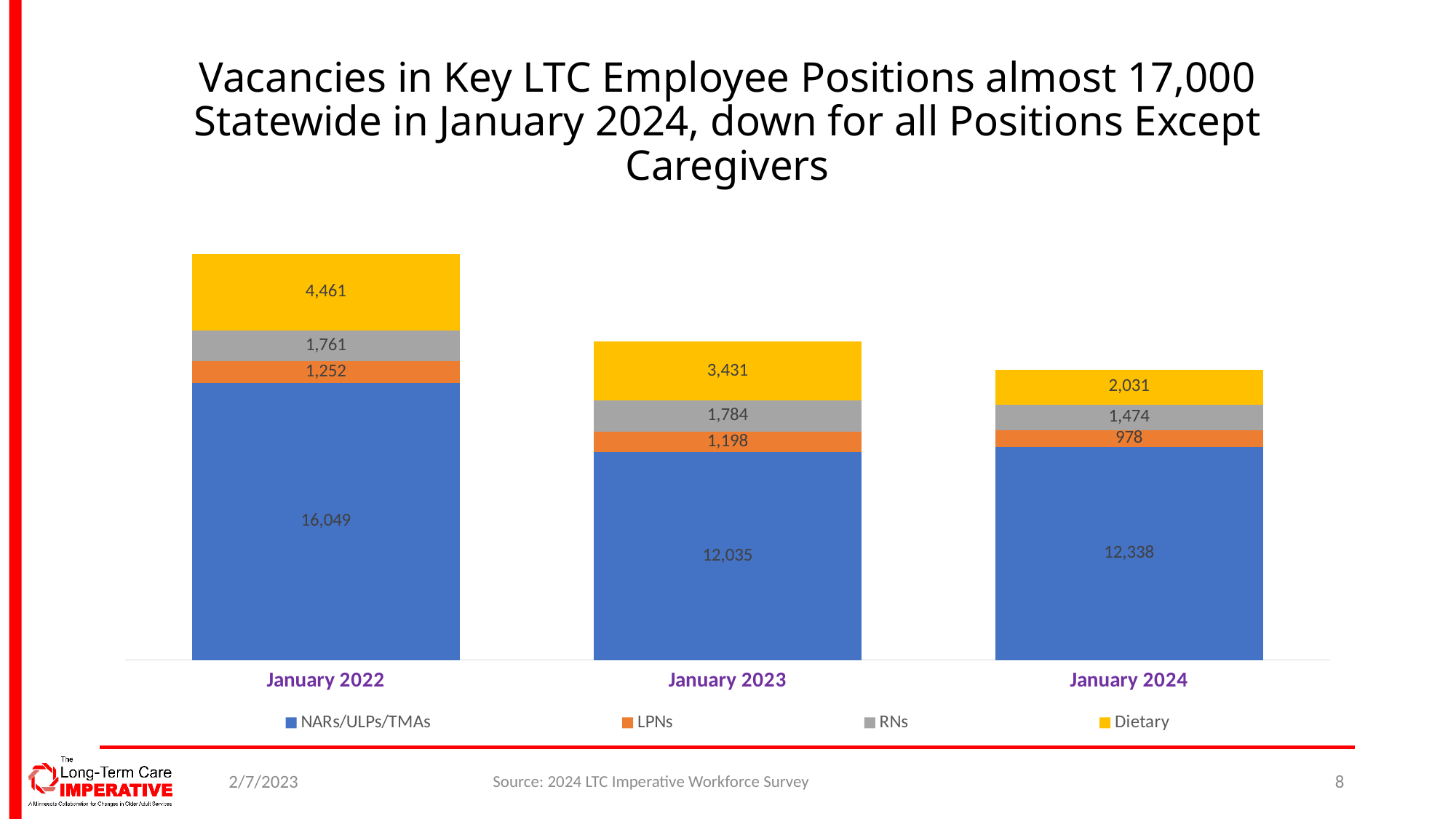
In which year is the Dietary value highest? January 2022 What is the difference between the Dietary values for January 2022 and January 2024? 2,430 What is the total of the stacked bar for January 2024? 16,821 In which year is the LPNs value lowest? January 2024 What is the value for NARs/ULPs/TMAs in January 2022? 16,049 Which is larger, the NARs/ULPs/TMAs value for January 2023 or for January 2024? January 2024 What kind of chart is shown on the slide? Stacked bar chart How many series does the legend list? 4 What is the value for LPNs in January 2023? 1,198 What is the value for RNs in January 2024? 1,474 Which colour represents Dietary in the chart? Yellow What is the value for Dietary in January 2024? 2,031